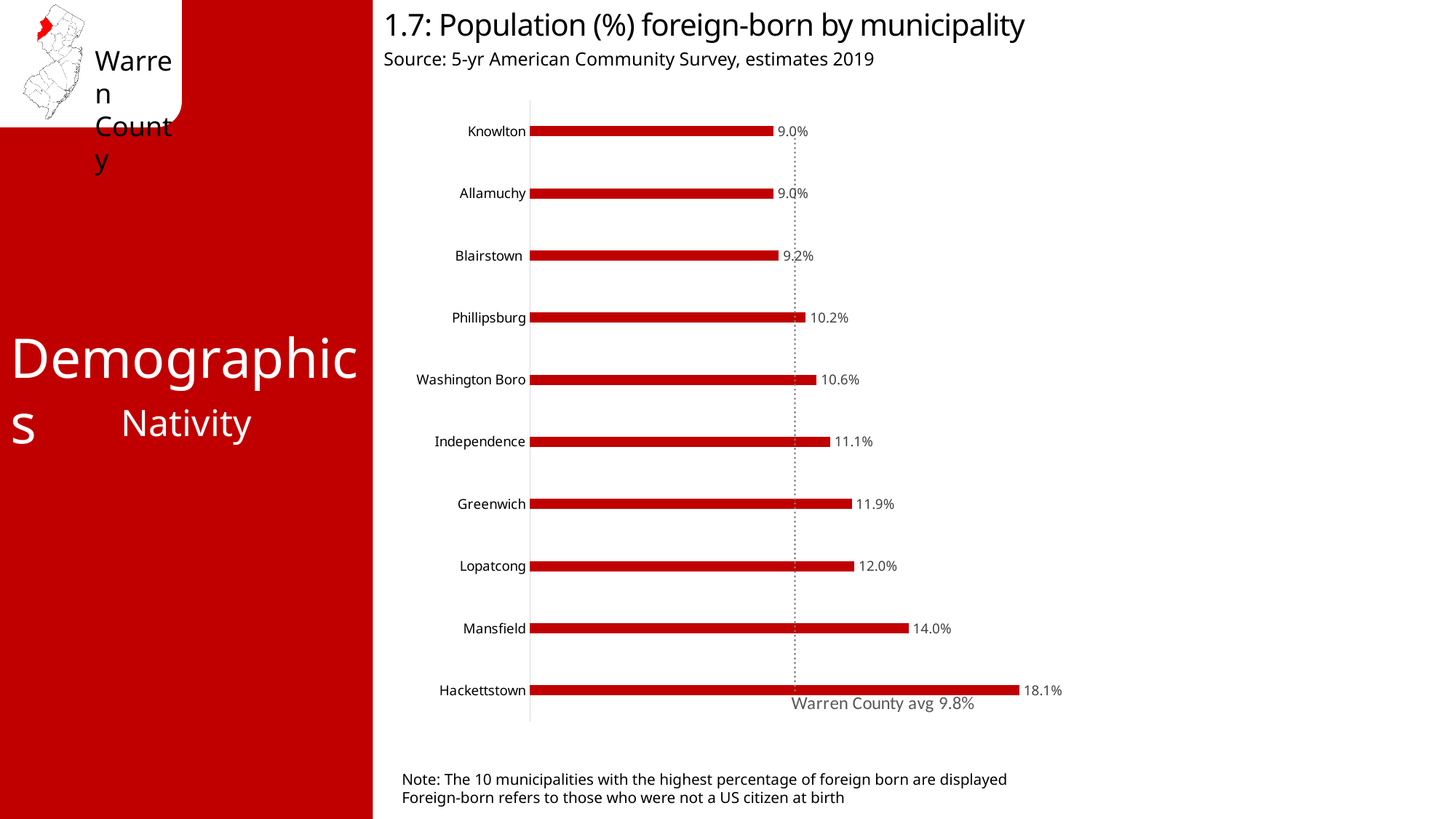
What is the percentage of foreign-born population in Washington Boro? 10.6% Which has a higher foreign-born percentage, Greenwich or Independence? Greenwich What is the percentage of foreign-born population in Hackettstown? 18.1% What is the difference in foreign-born percentage between Lopatcong and Blairstown? 2.8% What type of chart is used to show foreign-born population by municipality? Bar chart What is the percentage of foreign-born population in Phillipsburg? 10.2% What is the difference in foreign-born percentage between Hackettstown and Mansfield? 4.1% What is the Warren County average foreign-born percentage shown by the dotted line? 9.8% Which has a higher foreign-born percentage, Mansfield or Lopatcong? Mansfield What is the source of the data in the chart? 5-yr American Community Survey, estimates 2019 How many municipalities are shown in the chart? 10 Which municipality has the highest percentage of foreign-born population? Hackettstown